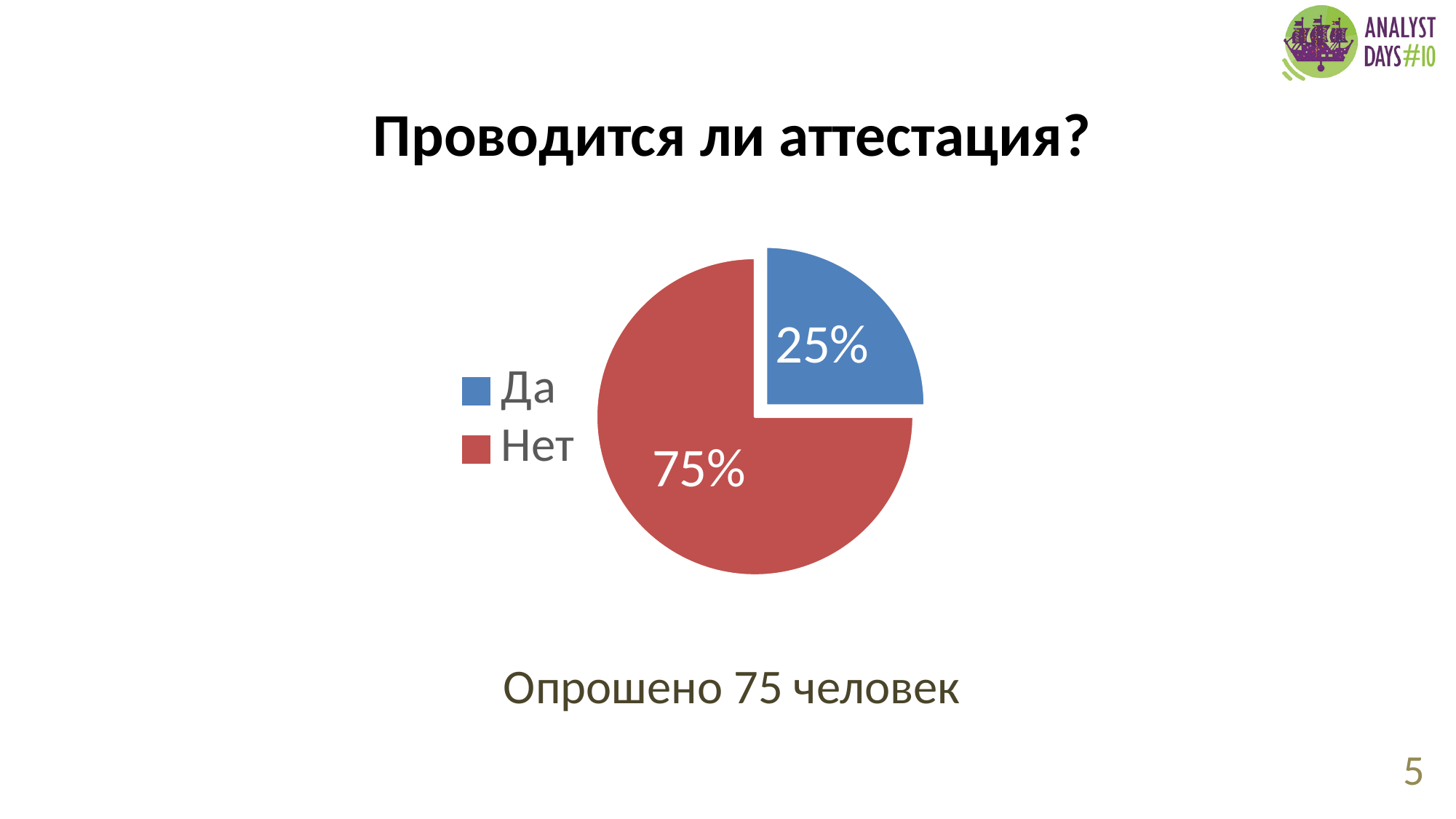
Which category has the largest slice of the pie? Нет What type of chart is shown on the slide? Pie chart How many categories are shown in the pie chart? 2 What is the title of the slide above the chart? Проводится ли аттестация? Which slice is larger, "Да" or "Нет"? Нет How many people were surveyed according to the text below the chart? 75 What is the difference in percentage points between the "Нет" and "Да" slices? 50% Which category has the smallest slice of the pie? Да What colour is the "Нет" slice in the pie chart? Red What share of the pie does "Нет" represent? 75% What share of the pie does "Да" represent? 25%